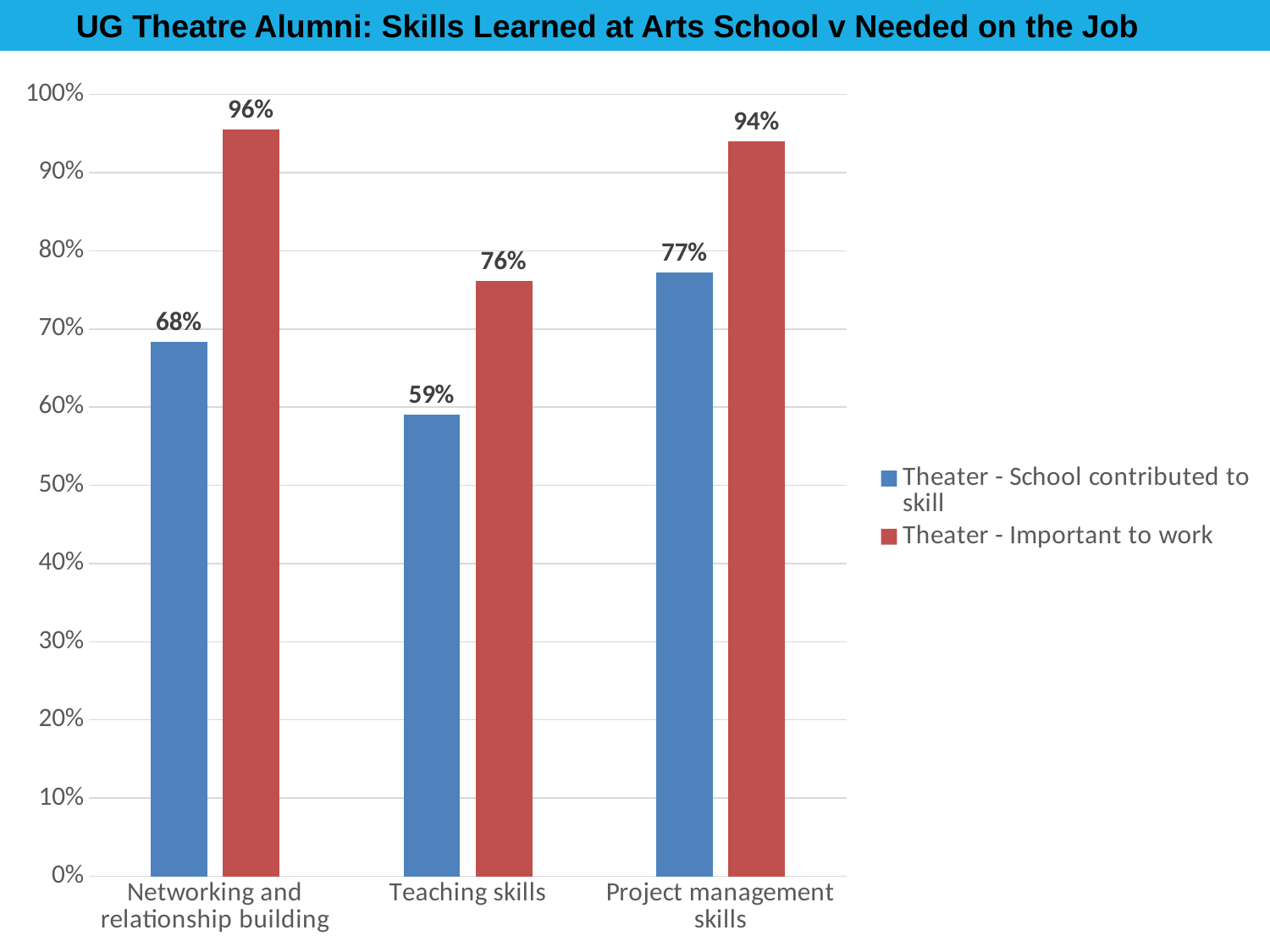
Which skill has the lowest 'Theater - School contributed to skill' value? Teaching skills What percentage of theatre alumni said school contributed to their networking and relationship building skill? 68% What kind of chart is shown on the slide? Bar chart For Project management skills, which is larger: 'School contributed to skill' or 'Important to work'? Important to work What is the value for 'Theater - School contributed to skill' for Project management skills? 77% How many skill categories are shown on the x axis? 3 What is the difference between 'Important to work' and 'School contributed to skill' for Teaching skills? 17% What is the value for 'Theater - Important to work' for Teaching skills? 76% What is the difference between 'Important to work' and 'School contributed to skill' for Networking and relationship building? 28% Which skill has the highest 'Theater - Important to work' value? Networking and relationship building What colour are the 'Theater - Important to work' bars? Red How many series does the legend list? 2